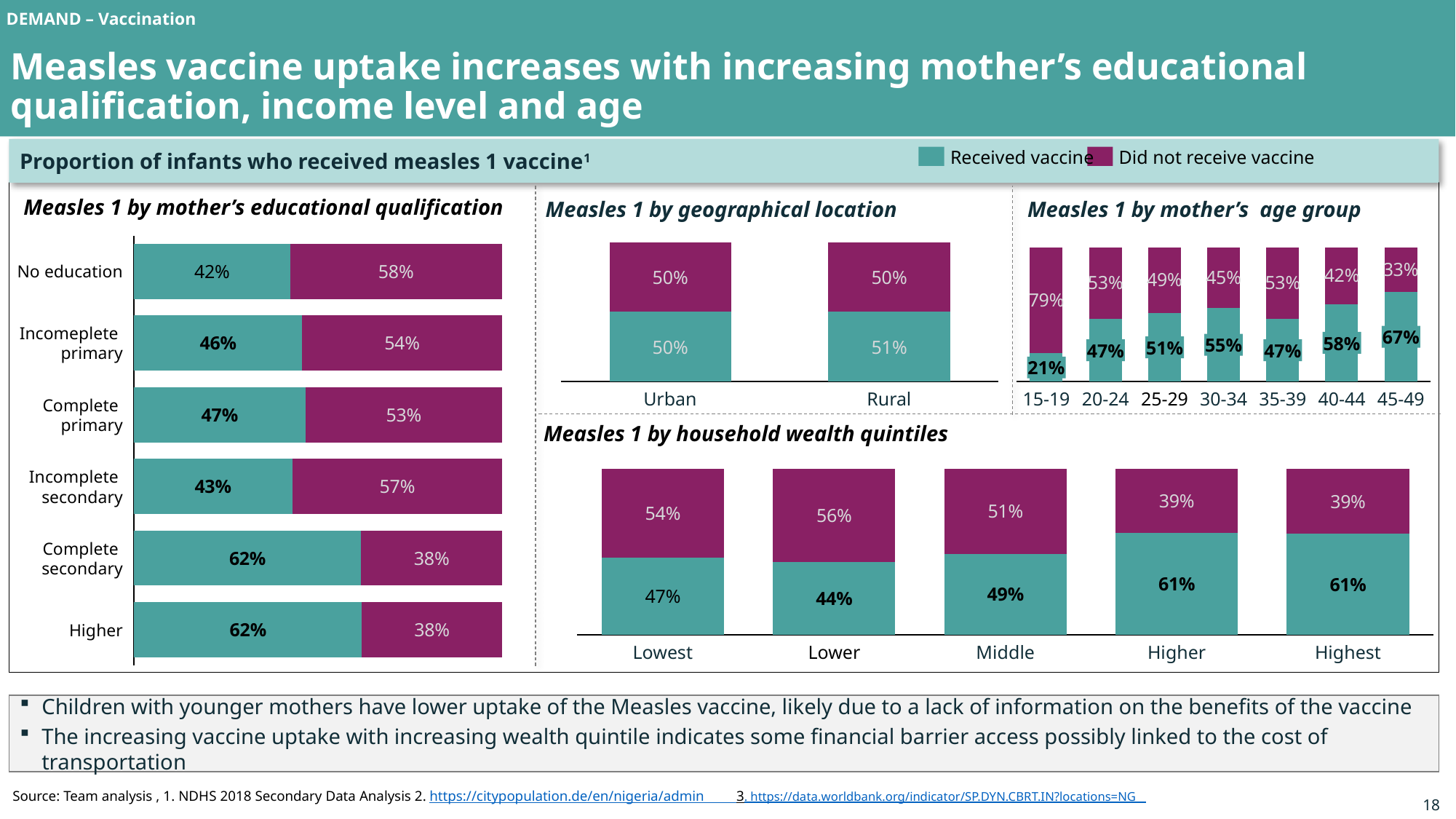
In the 'Measles 1 by mother's educational qualification' chart, what is the 'Did not receive vaccine' value for Incomplete secondary? 57% In the 'Measles 1 by mother's age group' chart, how many age groups are shown? 7 In the 'Measles 1 by mother's age group' chart, which age group has the highest 'Received vaccine' value? 45-49 In the 'Measles 1 by household wealth quintiles' chart, what is the 'Received vaccine' value for the Lower quintile? 44% In the 'Measles 1 by mother's educational qualification' chart, what is the difference between the 'Received vaccine' values for Complete secondary and Incomplete secondary? 19% In the 'Measles 1 by mother's age group' chart, what is the 'Did not receive vaccine' value for the 15-19 age group? 79% In the 'Measles 1 by mother's age group' chart, which age group has the lowest 'Received vaccine' value? 15-19 In the 'Measles 1 by mother's educational qualification' chart, how many educational categories are shown? 6 In the 'Measles 1 by household wealth quintiles' chart, which is larger, the 'Received vaccine' value for Middle or for Higher? Higher In the 'Measles 1 by mother's educational qualification' chart, what percentage of infants of mothers with no education received the vaccine? 42% How many series does the legend list? 2 In the 'Measles 1 by geographical location' chart, what percentage of rural infants received the vaccine? 51%